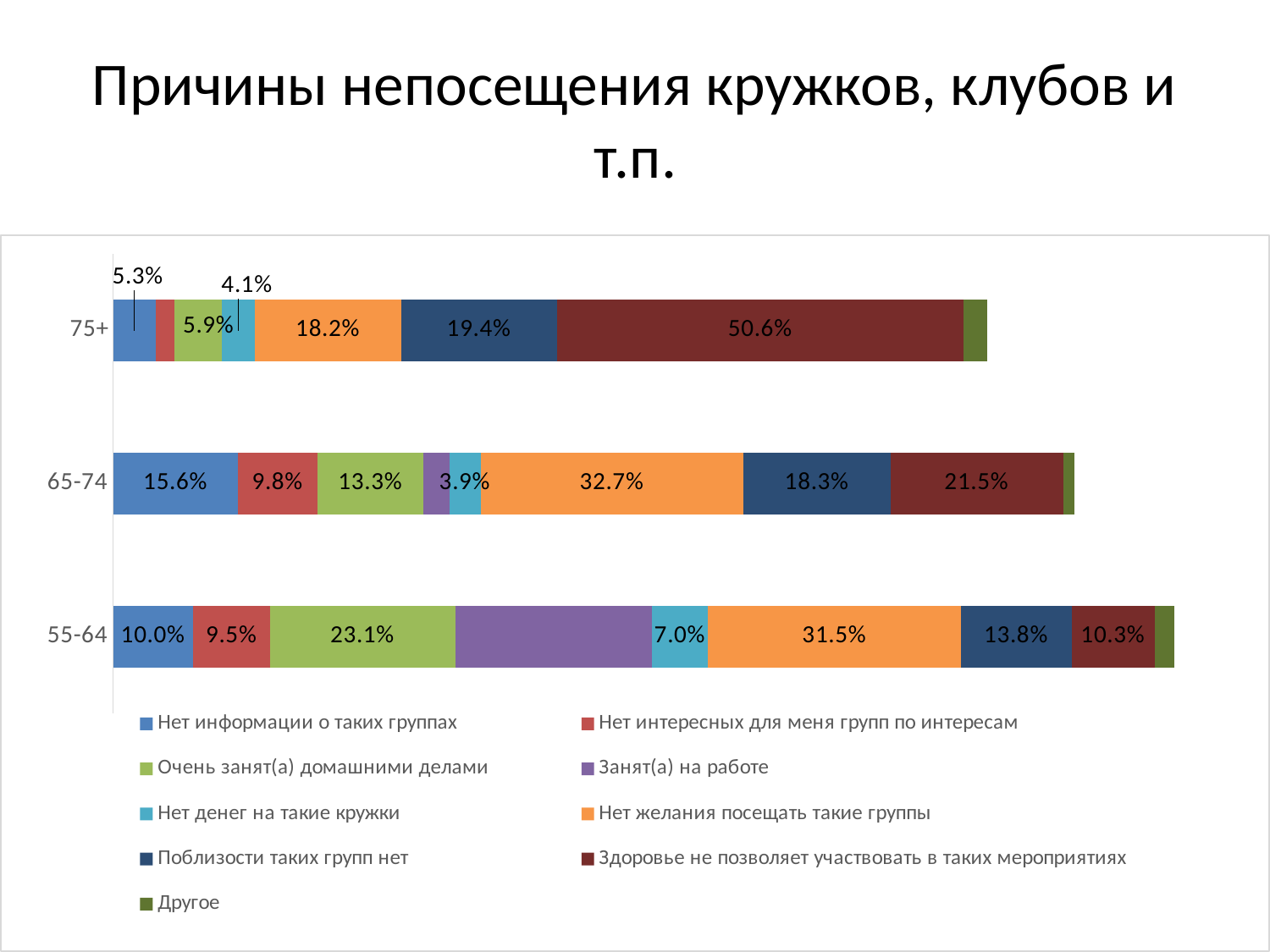
What kind of chart is shown on the slide? stacked bar chart What is the difference between the 'Нет желания посещать такие группы' values for the 65-74 and 55-64 groups? 1.2% What is the value for 'Очень занят(а) домашними делами' in the 55-64 group? 23.1% Which age group has the higher value for 'Нет информации о таких группах', 65-74 or 55-64? 65-74 What is the value for 'Нет денег на такие кружки' in the 75+ group? 4.1% How many age groups are shown on the chart? 3 What is the value for 'Нет желания посещать такие группы' in the 65-74 group? 32.7% How many series does the legend list? 9 Which reason has the highest value in the 75+ group? Здоровье не позволяет участвовать в таких мероприятиях What colour represents 'Нет желания посещать такие группы' in the chart? orange What is the value for 'Поблизости таких групп нет' in the 55-64 group? 13.8% What is the value for 'Здоровье не позволяет участвовать в таких мероприятиях' in the 75+ group? 50.6%